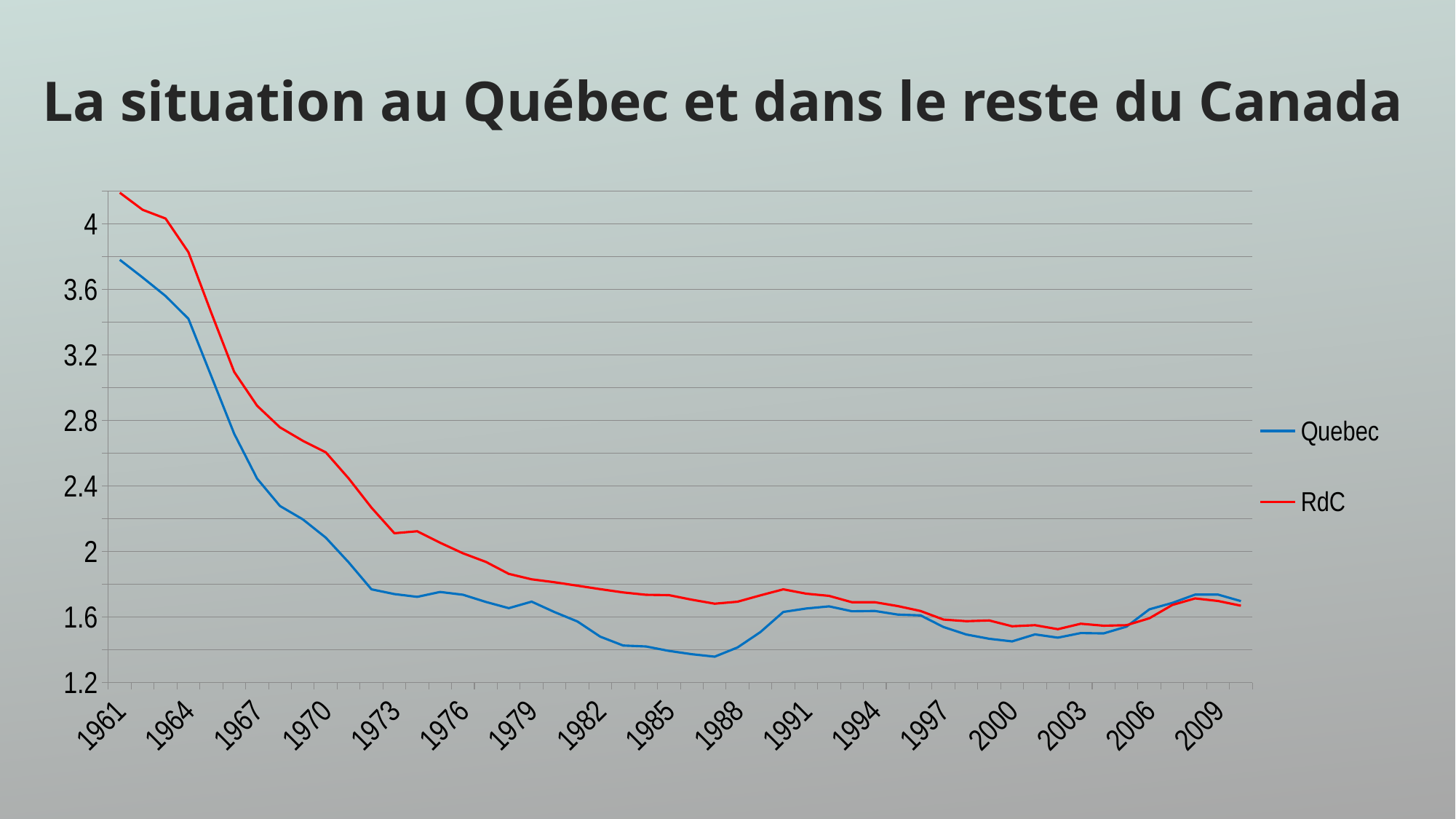
Is the value for RdC in 1961 greater or less than 4? greater What is the title of the slide? La situation au Québec et dans le reste du Canada Is the value for Quebec in 1988 greater or less than 1.6? less Is the value for RdC in 1973 greater or less than 2? greater In 1985, which series has the higher value, Quebec or RdC? RdC Does the Quebec line rise or fall between 1961 and 1973? fall What are the two series named in the legend? Quebec and RdC What kind of chart is shown on the slide? line chart How many series does the legend list? 2 In 1964, which series has the higher value, Quebec or RdC? RdC